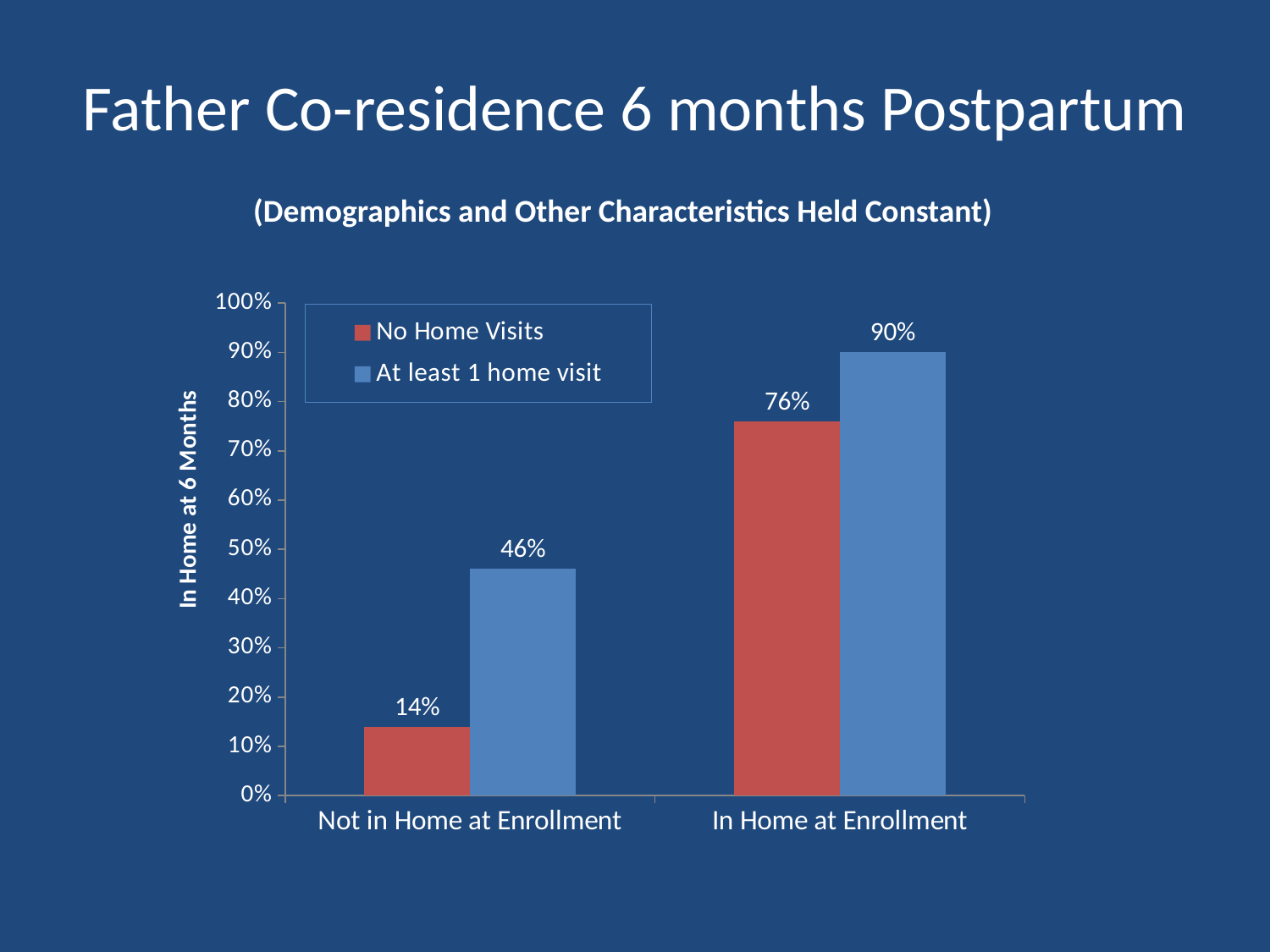
Which is larger: 'No Home Visits' for 'In Home at Enrollment' or 'At least 1 home visit' for 'Not in Home at Enrollment'? No Home Visits for In Home at Enrollment What is the difference between the 'At least 1 home visit' and 'No Home Visits' values in the 'In Home at Enrollment' category? 14% What is the difference between the 'At least 1 home visit' and 'No Home Visits' values in the 'Not in Home at Enrollment' category? 32% What is the value for 'At least 1 home visit' in the 'Not in Home at Enrollment' category? 46% What is the value for 'At least 1 home visit' in the 'In Home at Enrollment' category? 90% What is the value for 'No Home Visits' in the 'In Home at Enrollment' category? 76% What kind of chart is shown on the slide? Bar chart How many categories are shown on the x axis? 2 How many series does the legend list? 2 What is the value for 'No Home Visits' in the 'Not in Home at Enrollment' category? 14% Which bar has the highest value on the chart? At least 1 home visit, In Home at Enrollment Which bar has the lowest value on the chart? No Home Visits, Not in Home at Enrollment